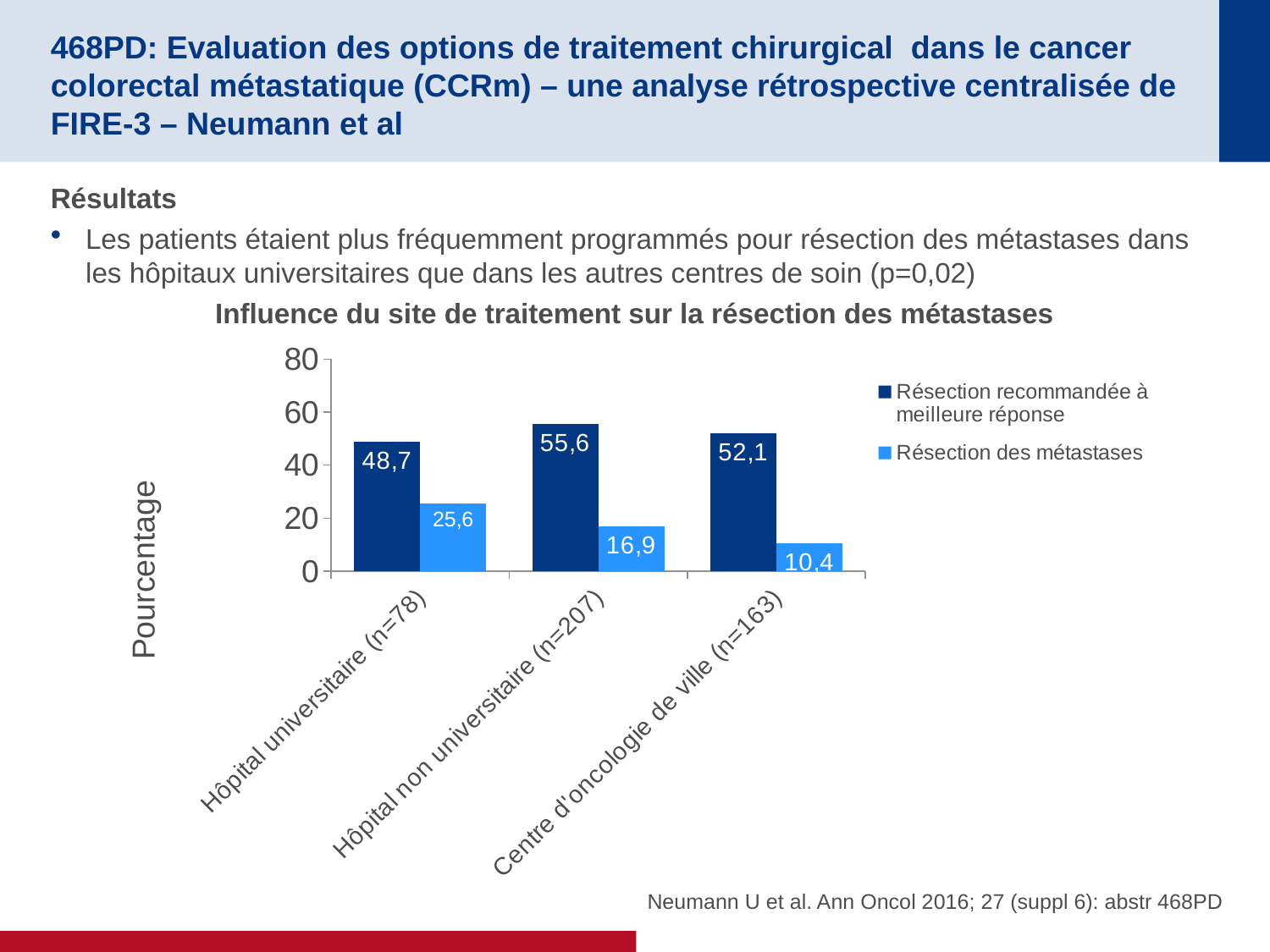
How many series does the legend list? 2 How many categories are shown on the x axis? 3 Which is larger: 'Résection des métastases' for Hôpital universitaire (n=78) or for Hôpital non universitaire (n=207)? Hôpital universitaire (n=78) What is the value of 'Résection des métastases' for Hôpital universitaire (n=78)? 25,6 What is the title of the chart? Influence du site de traitement sur la résection des métastases What is the difference between 'Résection recommandée à meilleure réponse' and 'Résection des métastases' for Hôpital universitaire (n=78)? 23,1 Which category has the lowest value for 'Résection des métastases'? Centre d'oncologie de ville (n=163) What is the value of 'Résection recommandée à meilleure réponse' for Hôpital non universitaire (n=207)? 55,6 What is the value of 'Résection des métastases' for Centre d'oncologie de ville (n=163)? 10,4 Is the value of 'Résection recommandée à meilleure réponse' for Centre d'oncologie de ville (n=163) greater or less than 40? greater What kind of chart is shown? bar chart Which category has the highest value for 'Résection recommandée à meilleure réponse'? Hôpital non universitaire (n=207)